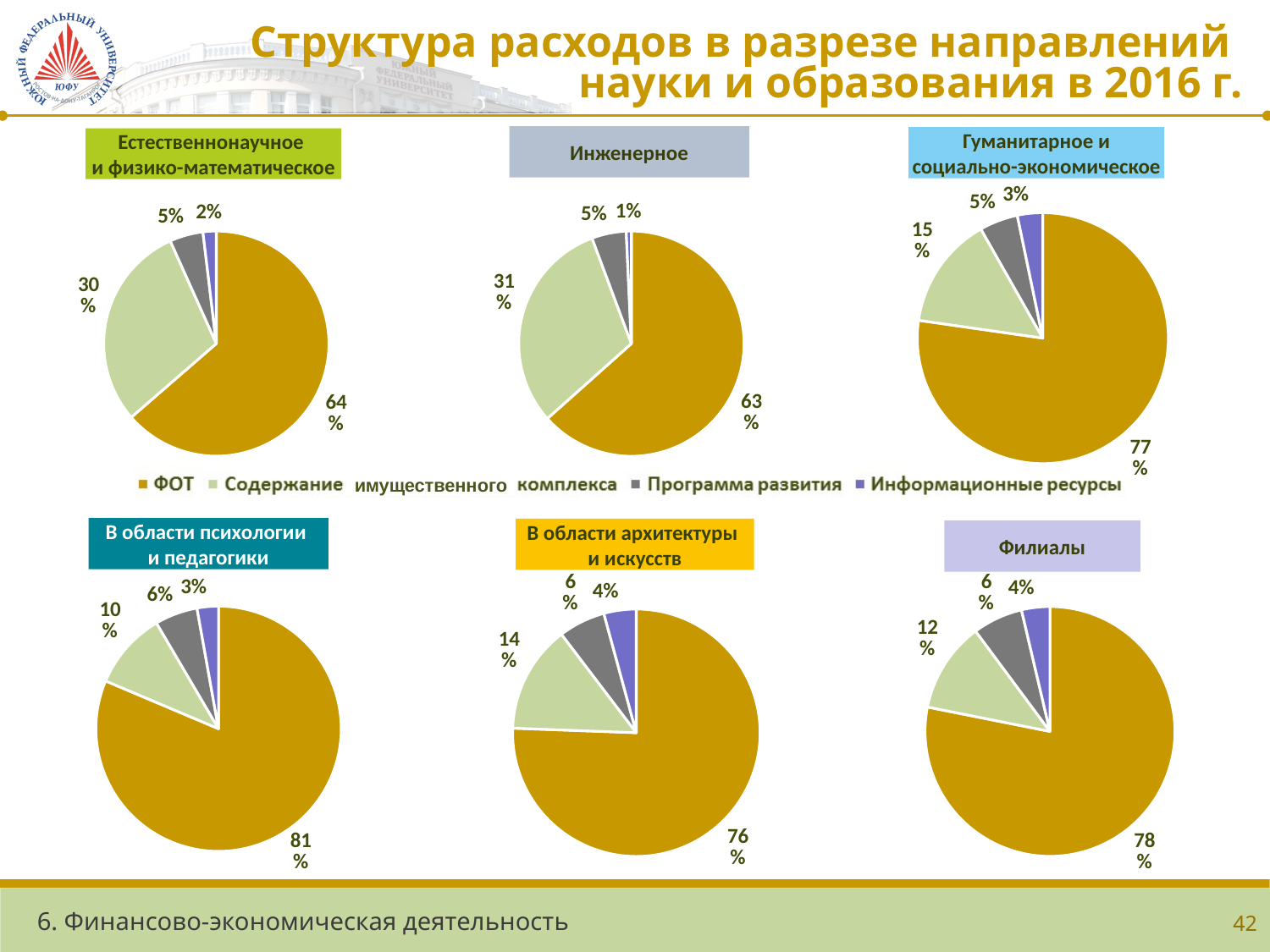
In the 'Естественнонаучное и физико-математическое' pie chart, which category has the smallest share? Информационные ресурсы In the 'Филиалы' pie chart, what share does 'Содержание имущественного комплекса' have? 12% Which is larger: the ФОТ share in the 'Инженерное' chart or the ФОТ share in the 'Филиалы' chart? Филиалы How many series does the shared legend list? 4 In the 'В области психологии и педагогики' pie chart, which category has the largest share? ФОТ In the 'Инженерное' pie chart, what share does ФОТ have? 63% What type of chart is used for 'Филиалы'? Pie chart In the 'Естественнонаучное и физико-математическое' pie chart, what share does 'Программа развития' have? 5% In the 'В области архитектуры и искусств' pie chart, what is the difference between the ФОТ share and the 'Содержание имущественного комплекса' share? 62% How many slices does the 'Инженерное' pie chart have? 4 In the 'Гуманитарное и социально-экономическое' pie chart, what share does 'Информационные ресурсы' have? 3% How many pie charts are on the slide? 6